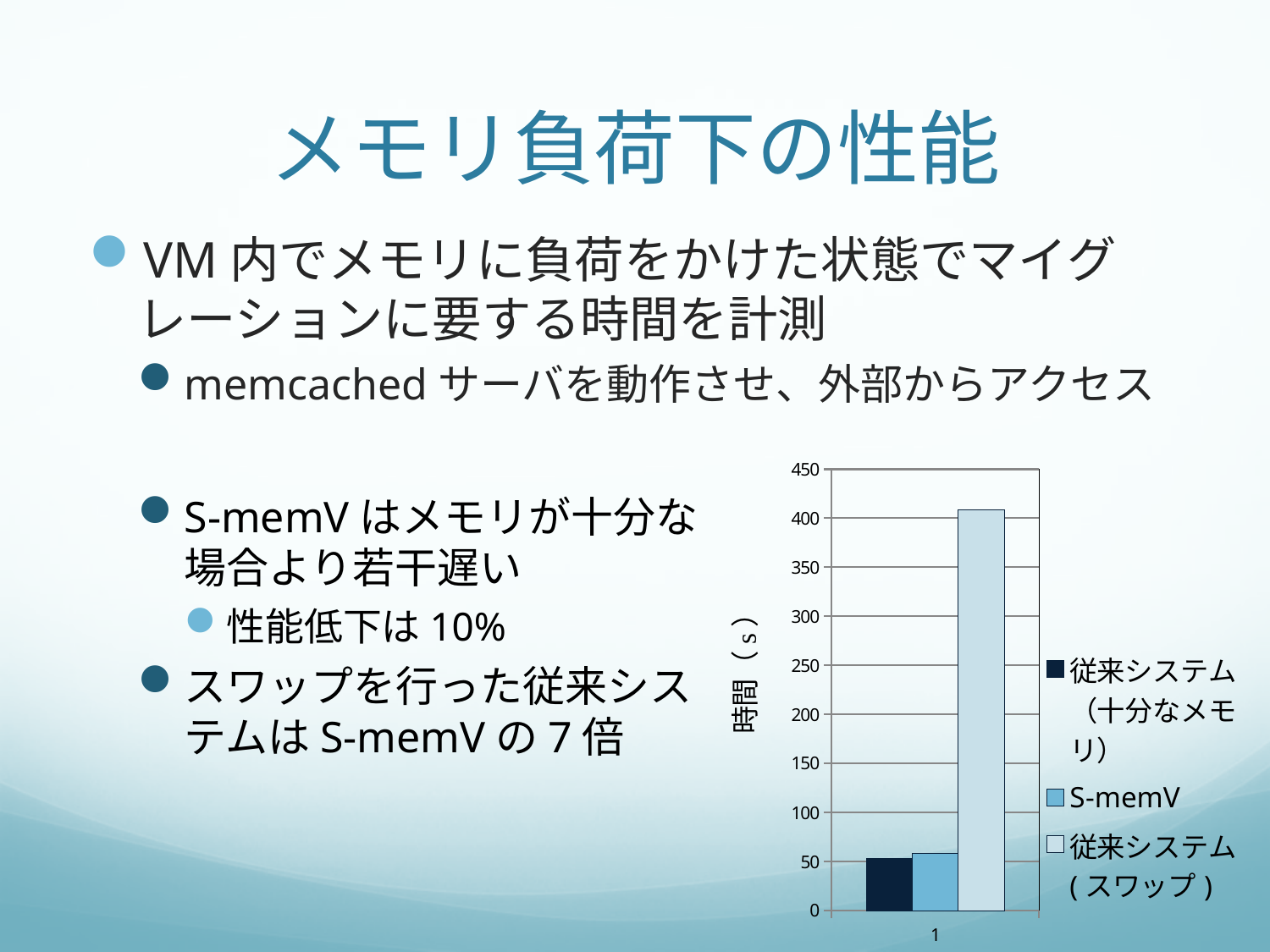
Is the value for 従来システム(スワップ) greater or less than 350? greater What kind of chart is shown on the slide? bar chart What is the label of the chart's y axis? 時間（s） How many series does the chart's legend list? 3 Which is larger, the value for 従来システム(スワップ) or the value for S-memV? 従来システム(スワップ) How many categories are shown on the x axis of the chart? 1 Is the value for 従来システム（十分なメモリ） greater or less than 100? less Which is larger, the value for 従来システム(スワップ) or the value for 従来システム（十分なメモリ）? 従来システム(スワップ) What is the highest tick value shown on the chart's y axis? 450 Is the value for S-memV greater or less than 100? less Which series has the highest value in the chart? 従来システム(スワップ)